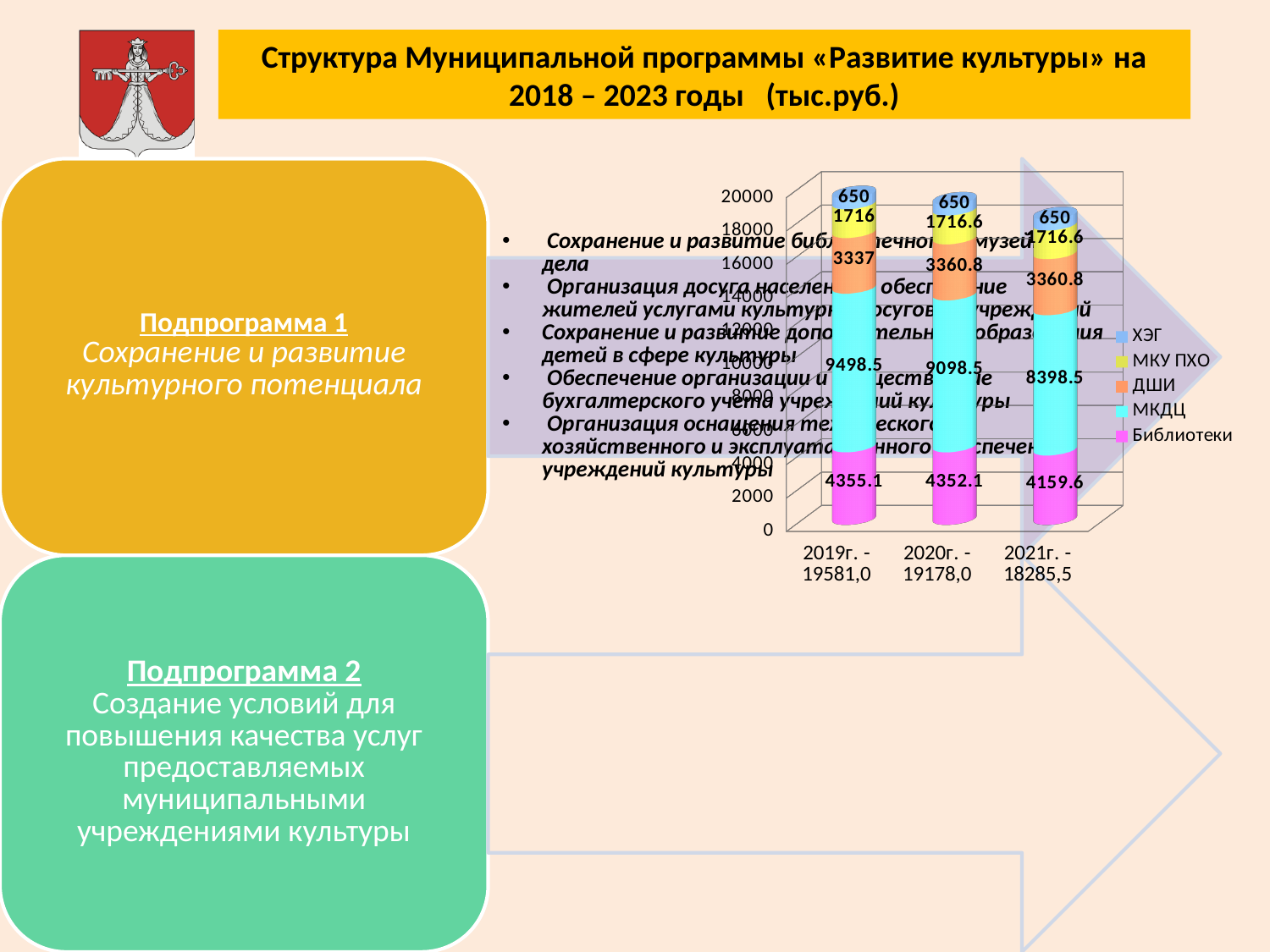
What is the difference between the МКДЦ values for 2019г. - 19581,0 and 2021г. - 18285,5? 1100 What is the value for ХЭГ in 2021г. - 18285,5? 650 What is the value for МКУ ПХО in 2019г. - 19581,0? 1716 How many series does the legend list? 5 How many categories (years) are shown on the x axis? 3 In which year is the value for Библиотеки the lowest? 2021г. - 18285,5 Does the value for МКДЦ rise or fall from 2019 to 2021? fall What is the value for ДШИ in 2020г. - 19178,0? 3360.8 Which is larger, the Библиотеки value for 2019г. - 19581,0 or for 2020г. - 19178,0? 2019г. - 19581,0 In which year is the value for МКДЦ the highest? 2019г. - 19581,0 What is the value for Библиотеки in 2021г. - 18285,5? 4159.6 What is the value for МКДЦ in 2019г. - 19581,0? 9498.5